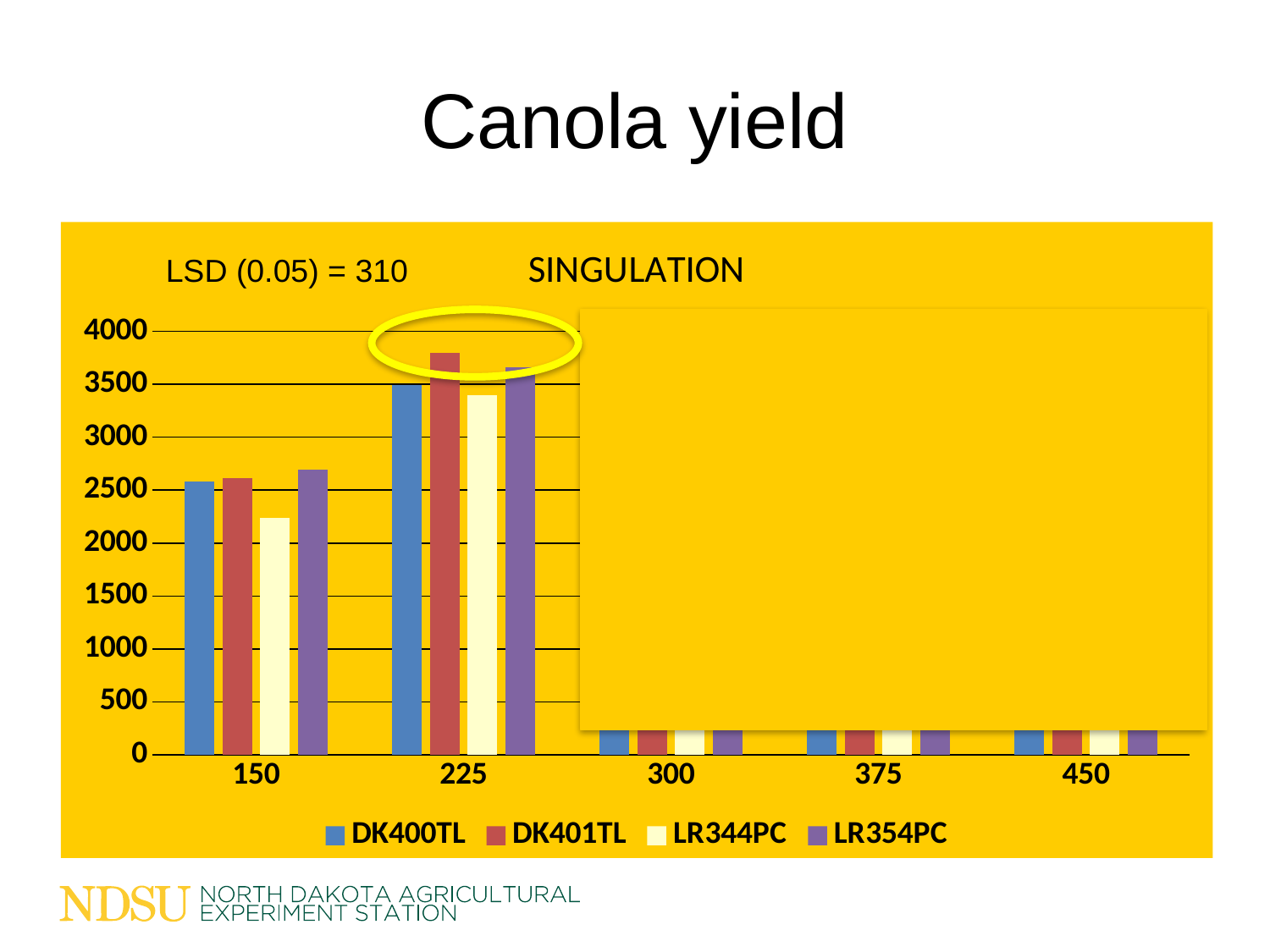
At 150, which is larger: LR354PC or LR344PC? LR354PC What kind of chart is shown on the slide? bar chart Which series has the lowest value at 150? LR344PC What LSD (0.05) value is printed on the chart? 310 How many categories are shown on the x axis? 5 Do the values for DK400TL rise or fall from 150 to 225? rise Is the value for LR344PC at 225 greater or less than 3500? less Is the value for LR354PC at 150 greater or less than 2500? greater Which series has the highest value at 225? DK401TL Is the value for LR344PC at 150 greater or less than 2500? less How many series does the legend list? 4